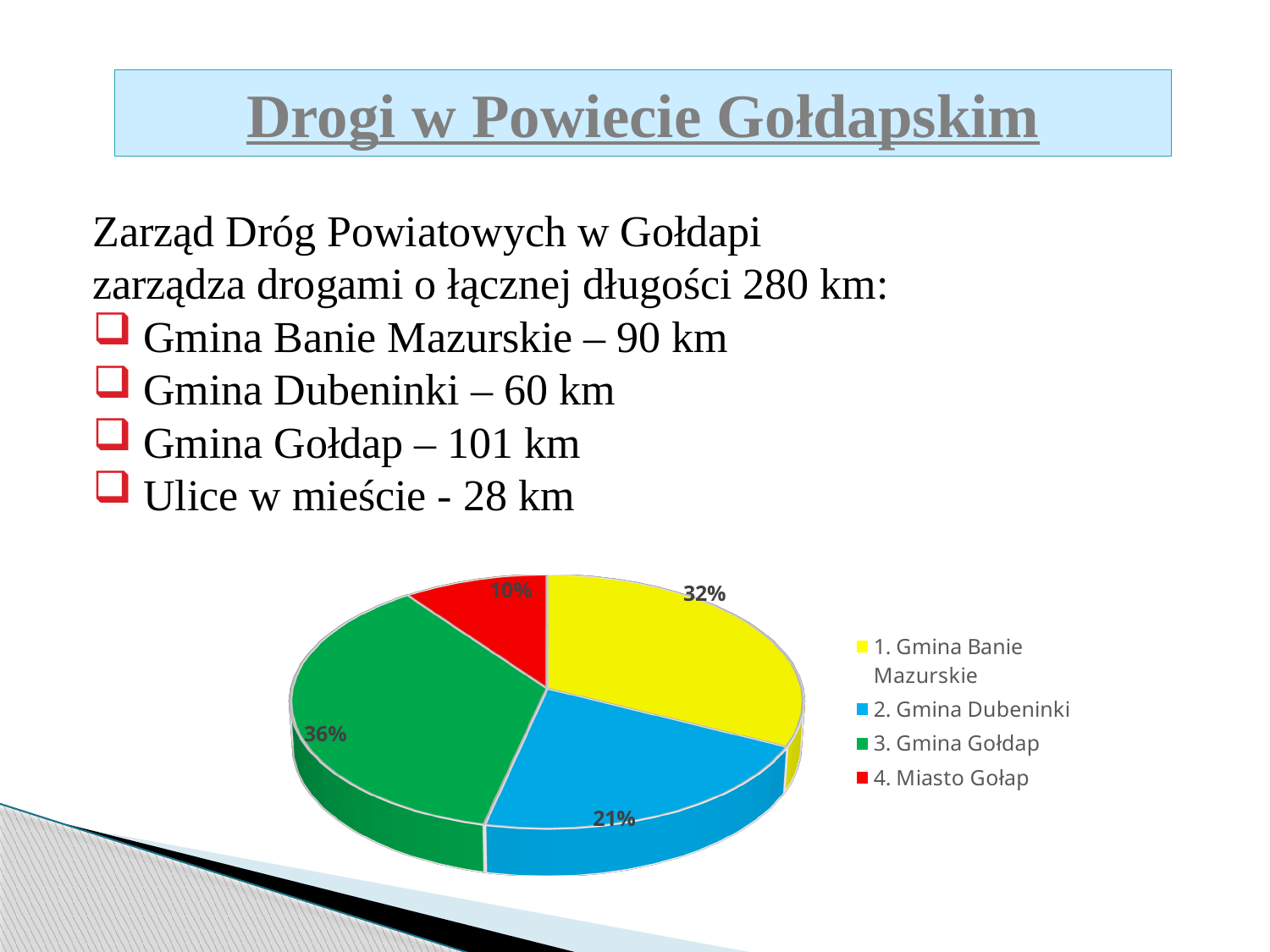
What percentage share does the slice for 1. Gmina Banie Mazurskie have? 32% Which category has the smallest slice of the pie? 4. Miasto Gołap What percentage share does the slice for 2. Gmina Dubeninki have? 21% What percentage share does the slice for 4. Miasto Gołap have? 10% Which slice is larger: 1. Gmina Banie Mazurskie or 2. Gmina Dubeninki? 1. Gmina Banie Mazurskie What kind of chart is shown on the slide? pie chart What is the difference in percentage points between the slices for 3. Gmina Gołdap and 2. Gmina Dubeninki? 15 How many entries does the chart legend list? 4 How many slices does the pie chart have? 4 Which category has the largest slice of the pie? 3. Gmina Gołdap What percentage share does the slice for 3. Gmina Gołdap have? 36% What colour is the slice for 2. Gmina Dubeninki? blue